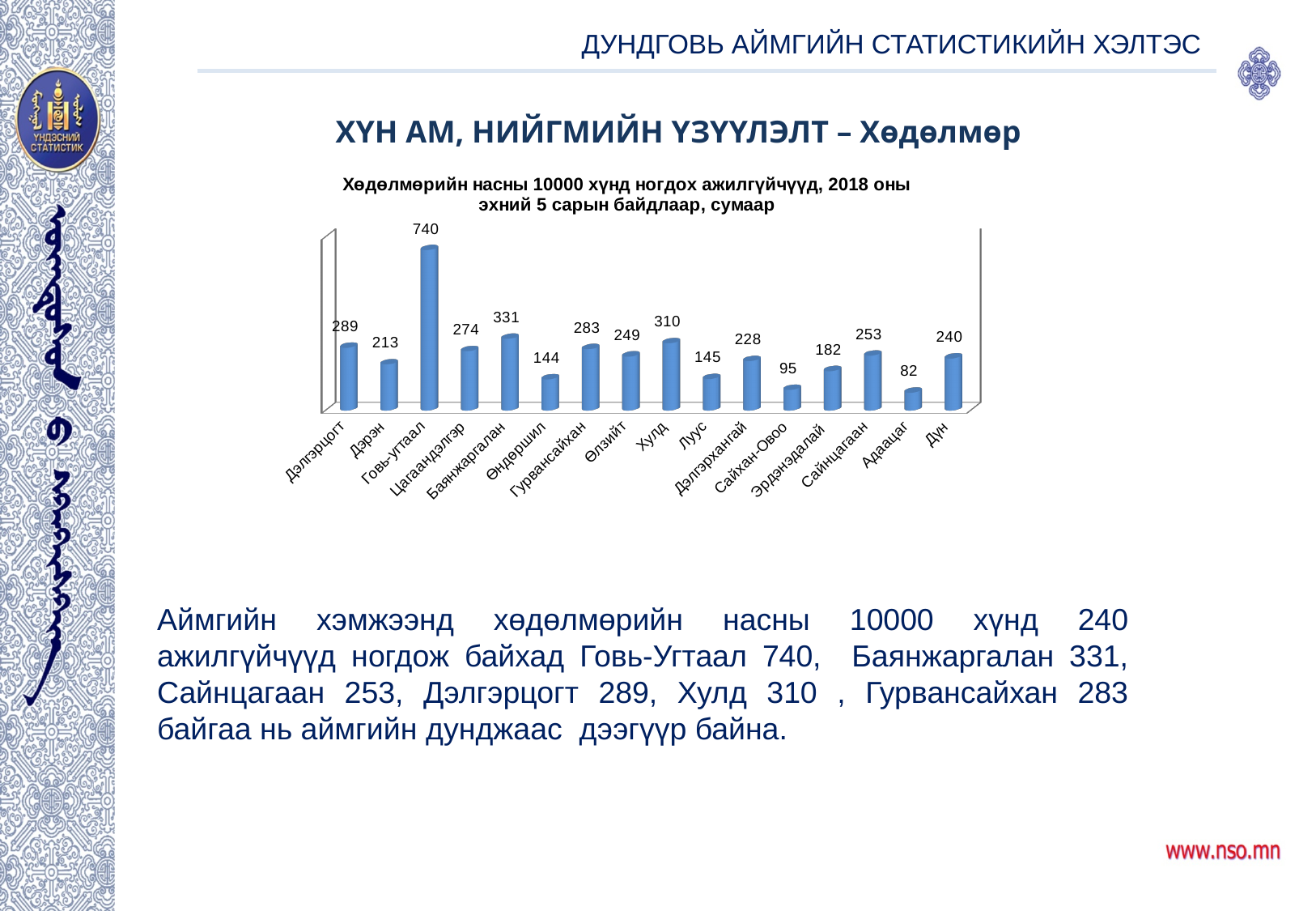
What kind of chart is shown on the slide? Bar chart Which category has the lowest value? Адаацаг Which is larger, the value for Эрдэнэдалай or the value for Сайнцагаан? Сайнцагаан Which is larger, the value for Дэлгэрцогт or the value for Гурвансайхан? Дэлгэрцогт What is the value for Сайхан-Овоо? 95 Which category has the highest value? Говь-Угтаал What is the value for Баянжаргалан? 331 What is the difference between the values for Говь-Угтаал and Баянжаргалан? 409 How many categories are shown on the x axis? 16 What is the difference between the values for Хулд and Дүн? 70 What is the value for Говь-Угтаал? 740 What is the value for Дүн? 240